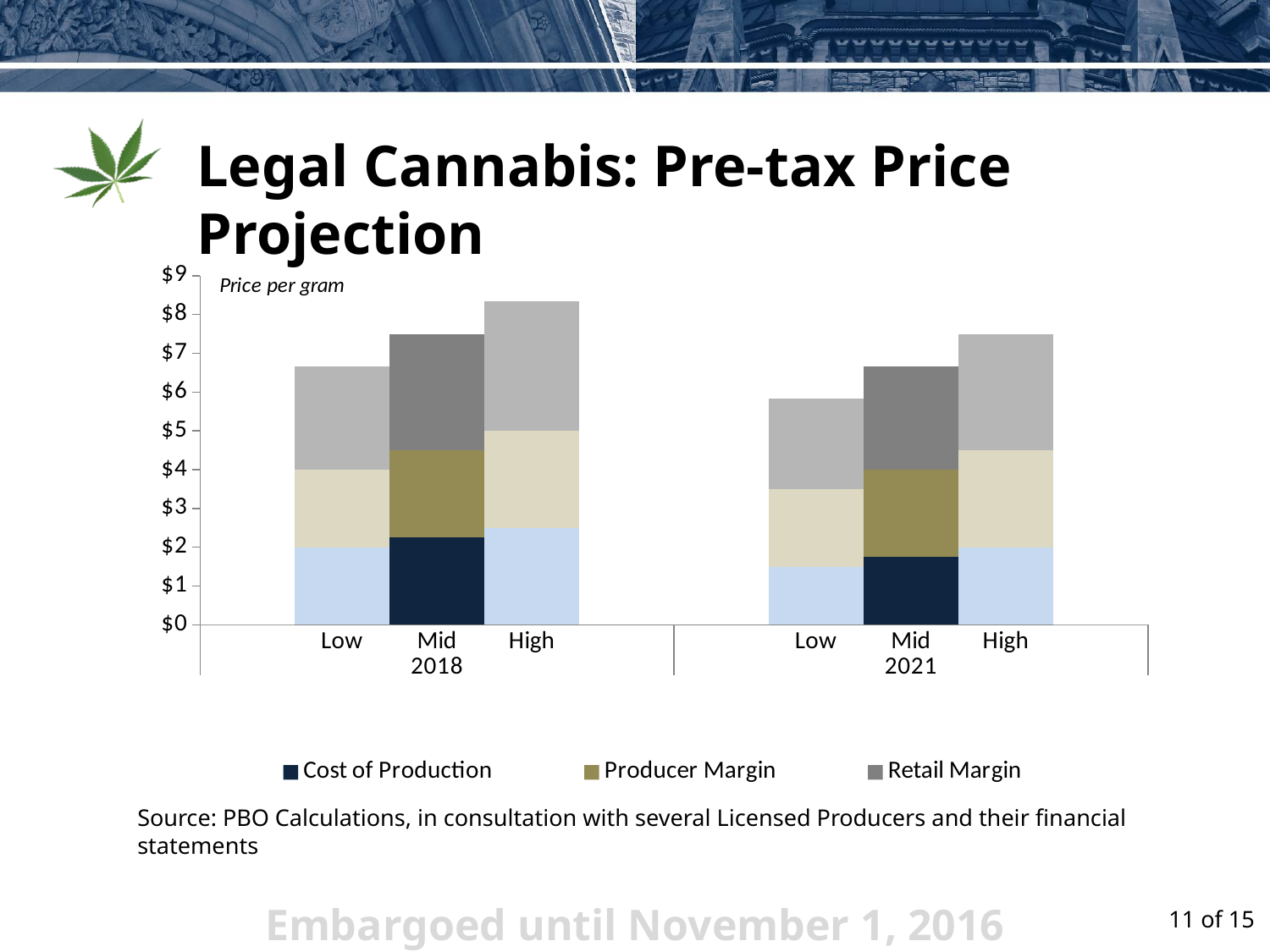
Is the total for the High 2018 bar greater or less than $8? greater What kind of chart is shown on the slide? Stacked bar chart Which legend entry is shown in the darkest colour? Cost of Production Is the total for the Mid 2018 bar greater or less than $7? greater Which bar has the lowest total pre-tax price? Low 2021 What unit label is shown at the top of the chart's vertical axis? Price per gram How many series does the legend list? 3 Is the total for the Low 2021 bar greater or less than $6? less Which has a larger total pre-tax price, Low 2018 or Low 2021? Low 2018 How many stacked bars are plotted in the chart? 6 Which bar has the highest total pre-tax price? High 2018